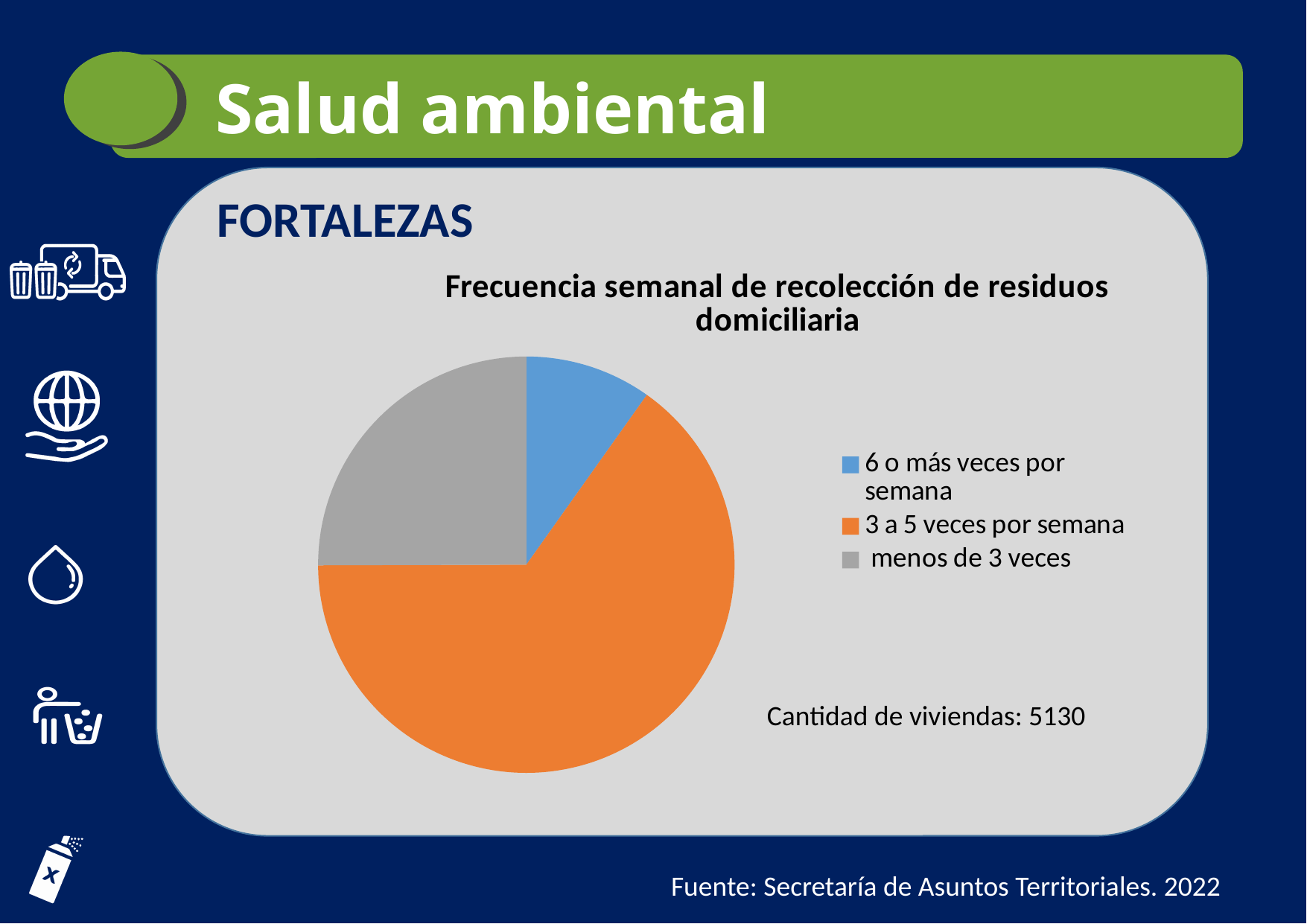
Which slice is larger: "3 a 5 veces por semana" or "menos de 3 veces"? 3 a 5 veces por semana Which category has the largest slice of the pie? 3 a 5 veces por semana Which category has the smallest slice of the pie? 6 o más veces por semana How many slices does the pie chart have? 3 How many entries does the legend list? 3 What kind of chart is shown on the slide? pie chart What is the title of the chart? Frecuencia semanal de recolección de residuos domiciliaria Which colour represents "menos de 3 veces" in the pie chart? gray Which slice is larger: "menos de 3 veces" or "6 o más veces por semana"? menos de 3 veces Does the "3 a 5 veces por semana" slice cover more or less than half of the pie? more